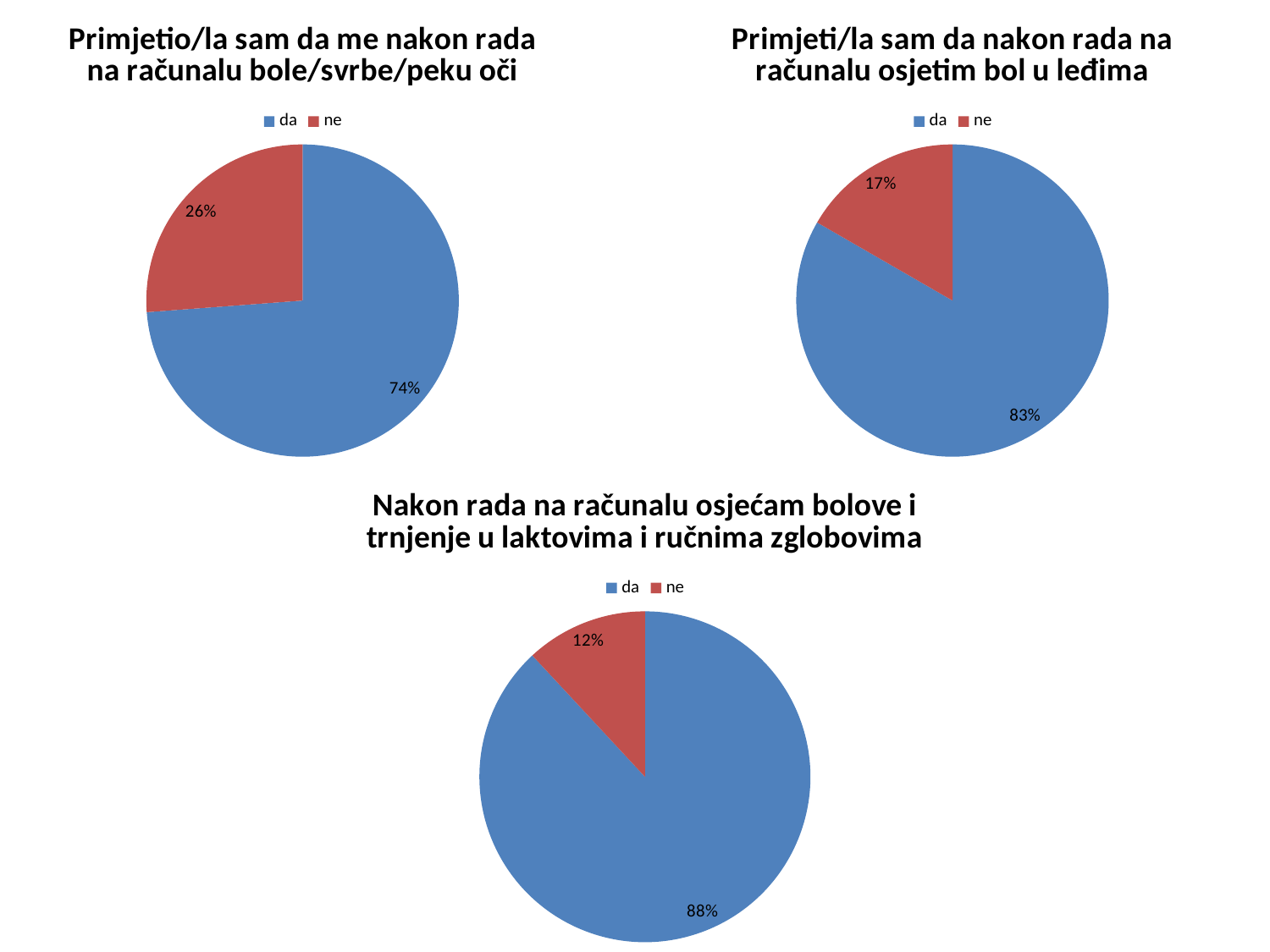
In the top-left chart, which is larger, "da" or "ne"? da In the top-right chart ("Primjeti/la sam da nakon rada na računalu osjetim bol u leđima"), what is the value for "da"? 83% In the top-left chart ("Primjetio/la sam da me nakon rada na računalu bole/svrbe/peku oči"), what share of the pie is "da"? 74% In the top-right chart, what is the difference between the "da" and "ne" values? 66% In the bottom chart ("Nakon rada na računalu osjećam bolove i trnjenje u laktovima i ručnima zglobovima"), what is the value for "da"? 88% In the bottom chart ("Nakon rada na računalu osjećam bolove i trnjenje u laktovima i ručnima zglobovima"), what is the value for "ne"? 12% In the top-left chart ("Primjetio/la sam da me nakon rada na računalu bole/svrbe/peku oči"), what is the value for "ne"? 26% How many entries does the legend of the top-right chart list? 2 In the top-left chart, which category has the largest slice? da In the top-right chart ("Primjeti/la sam da nakon rada na računalu osjetim bol u leđima"), what share of the pie is "ne"? 17% What kind of chart is the bottom chart? Pie chart In the bottom chart, which category has the smallest slice? ne